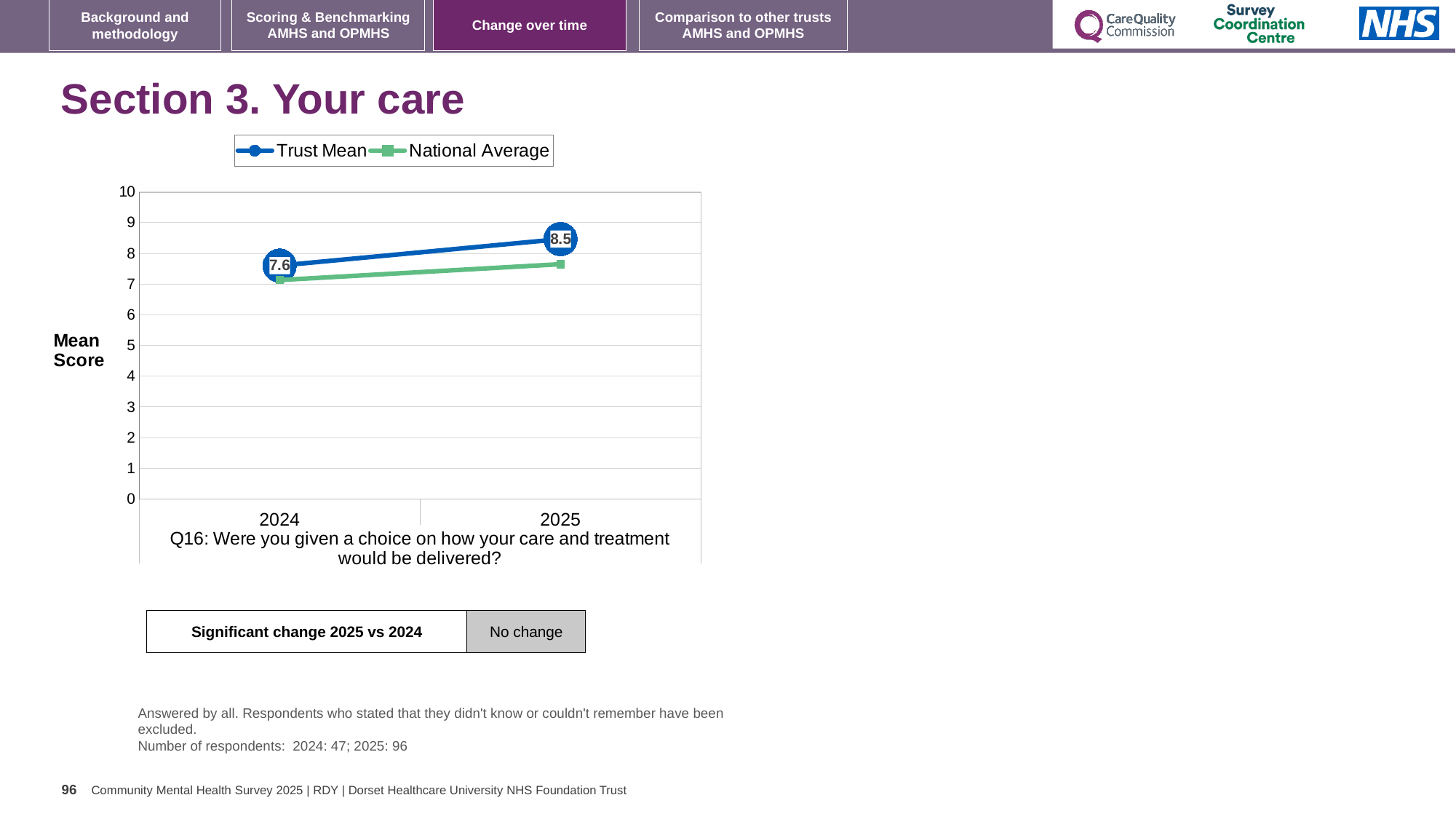
Which year has the higher Trust Mean score? 2025 In 2025, which is larger: the Trust Mean or the National Average? Trust Mean Is the National Average value for 2024 greater or less than 8? less What is the label on the y axis of the chart? Mean Score How many series does the legend list? 2 How many years are plotted on the x axis? 2 What is the Trust Mean score for 2024? 7.6 By how much did the Trust Mean score change from 2024 to 2025? 0.9 Does the National Average rise or fall from 2024 to 2025? rise What is the Trust Mean score for 2025? 8.5 What kind of chart is shown on the slide? line chart Does the Trust Mean rise or fall from 2024 to 2025? rise